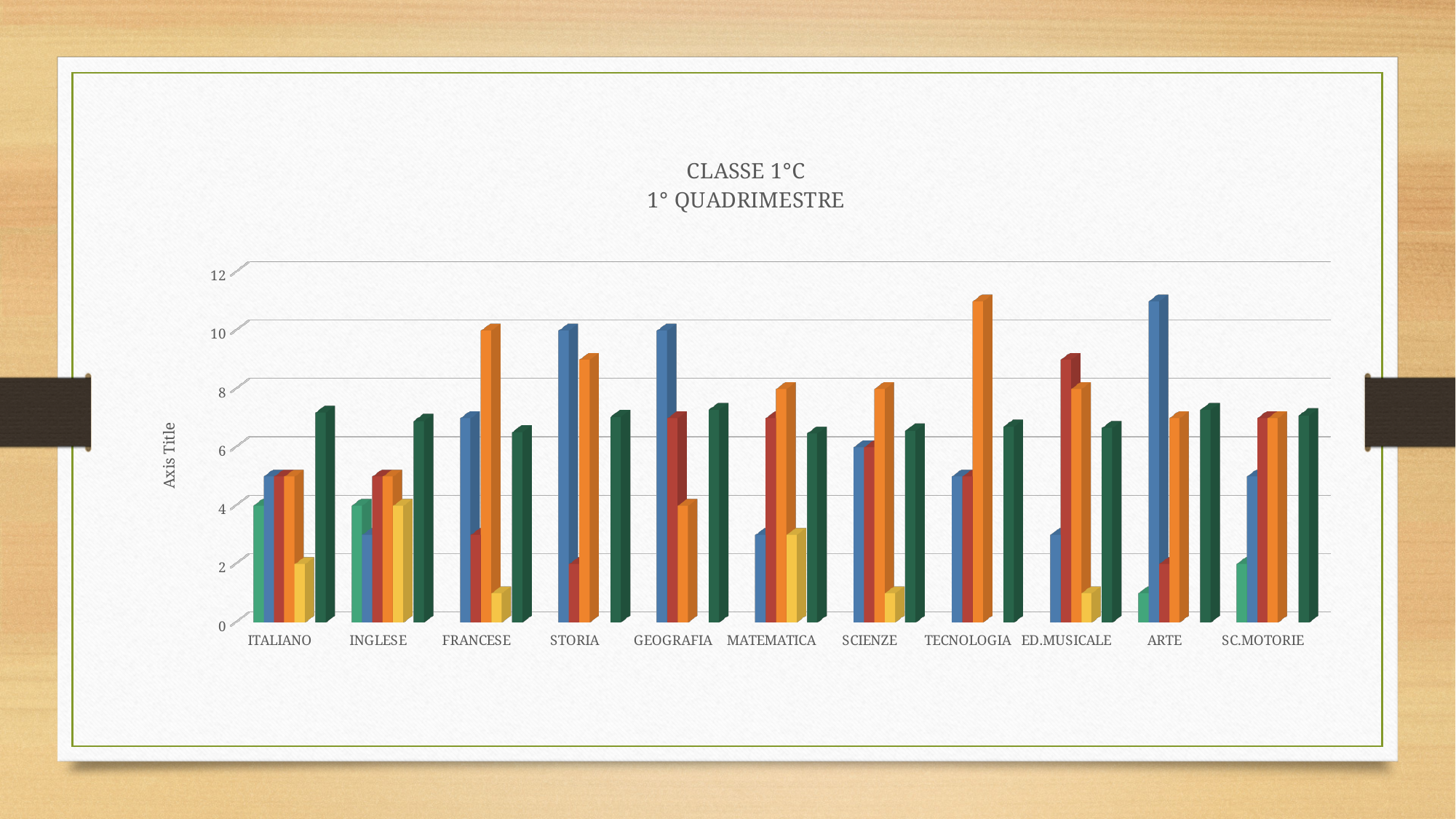
What label is shown on the vertical axis of the chart? Axis Title Is the value of the blue bar for STORIA greater or less than 8? greater What kind of chart is shown on the slide? bar chart Is the value of the orange bar for TECNOLOGIA greater or less than 10? greater Is the value of the yellow bar for ITALIANO greater or less than 4? less What is the title of the chart? CLASSE 1°C 1° QUADRIMESTRE How many subject categories are shown on the x axis of the chart? 11